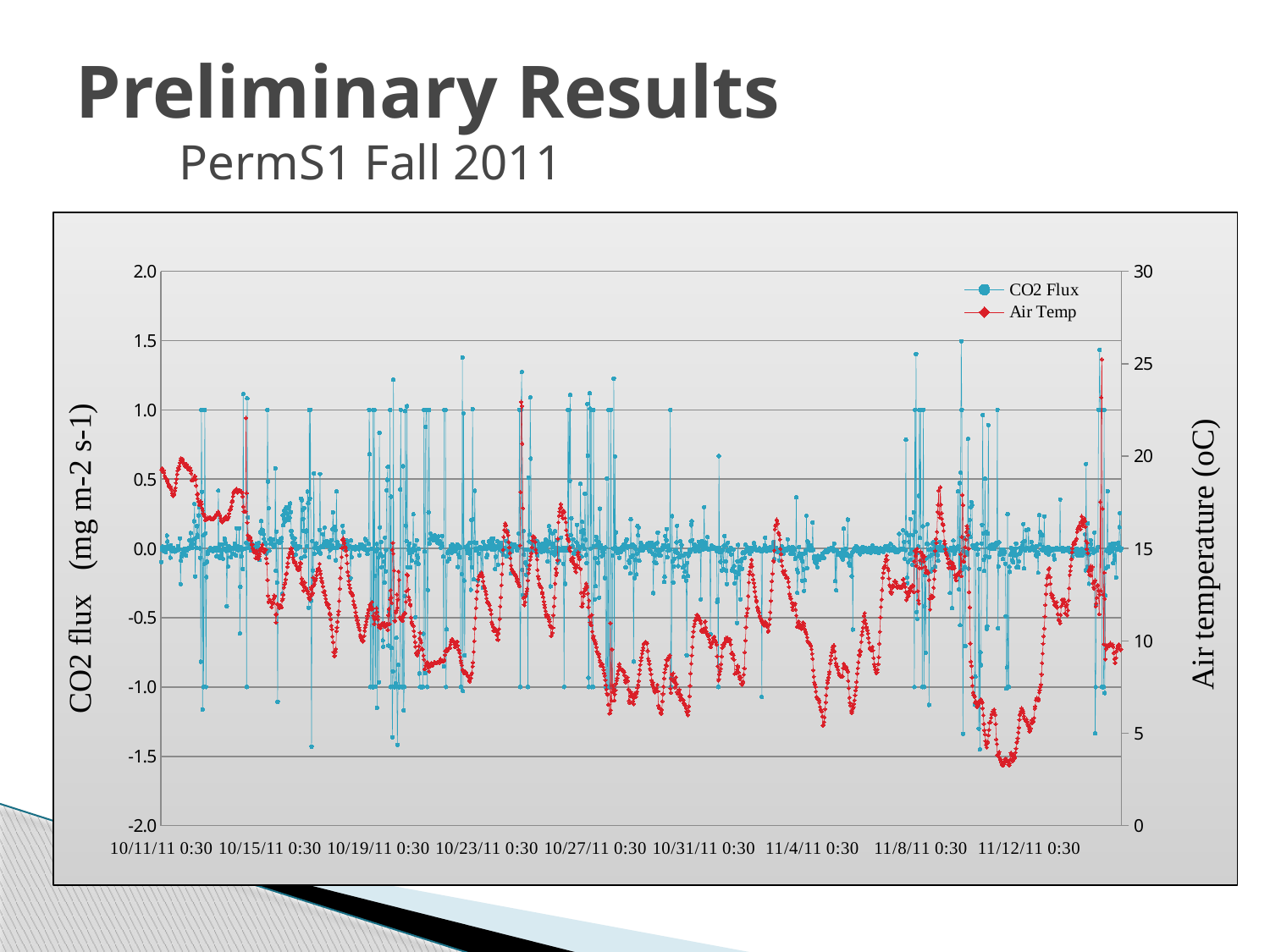
Is the highest Air Temp value on the chart greater or less than 20? greater What are the two series named in the legend? CO2 Flux and Air Temp Is the lowest CO2 Flux value on the chart greater or less than -1.0? less What is the label of the right-hand vertical axis? Air temperature (oC) Is the lowest Air Temp value on the chart greater or less than 5? less Does the Air Temp series generally rise or fall between 10/11/11 0:30 and 10/27/11 0:30? fall How many series does the legend list? 2 What kind of chart is shown on the slide? line chart